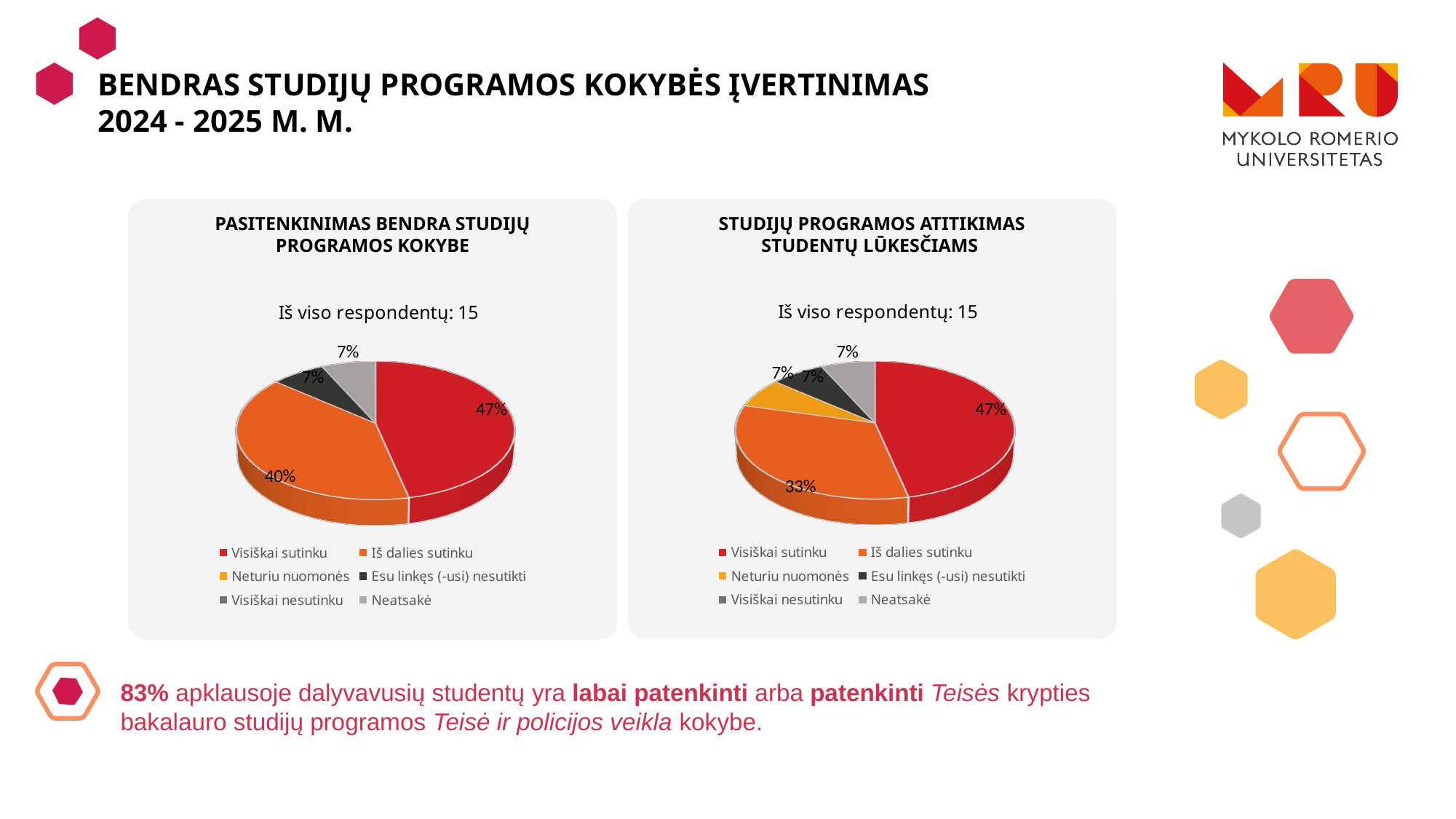
In the right chart (Studijų programos atitikimas studentų lūkesčiams), which category has the largest slice? Visiškai sutinku How many entries does the legend of the left chart (Pasitenkinimas bendra studijų programos kokybe) list? 6 Which chart has the larger share for Iš dalies sutinku, the left one or the right one? The left one In the right chart (Studijų programos atitikimas studentų lūkesčiams), what share is labelled for Iš dalies sutinku? 33% In the left chart (Pasitenkinimas bendra studijų programos kokybe), what share is labelled for Iš dalies sutinku? 40% In the left chart (Pasitenkinimas bendra studijų programos kokybe), what share is labelled for Visiškai sutinku? 47% In the left chart (Pasitenkinimas bendra studijų programos kokybe), which category has the largest slice? Visiškai sutinku How many respondents does the right chart (Studijų programos atitikimas studentų lūkesčiams) report in total? 15 In the right chart (Studijų programos atitikimas studentų lūkesčiams), what share is labelled for Visiškai sutinku? 47% In the right chart (Studijų programos atitikimas studentų lūkesčiams), what is the difference between the Visiškai sutinku and Iš dalies sutinku shares? 14% In the left chart (Pasitenkinimas bendra studijų programos kokybe), what is the difference between the Visiškai sutinku and Iš dalies sutinku shares? 7% What type of chart is used on this slide? Pie chart